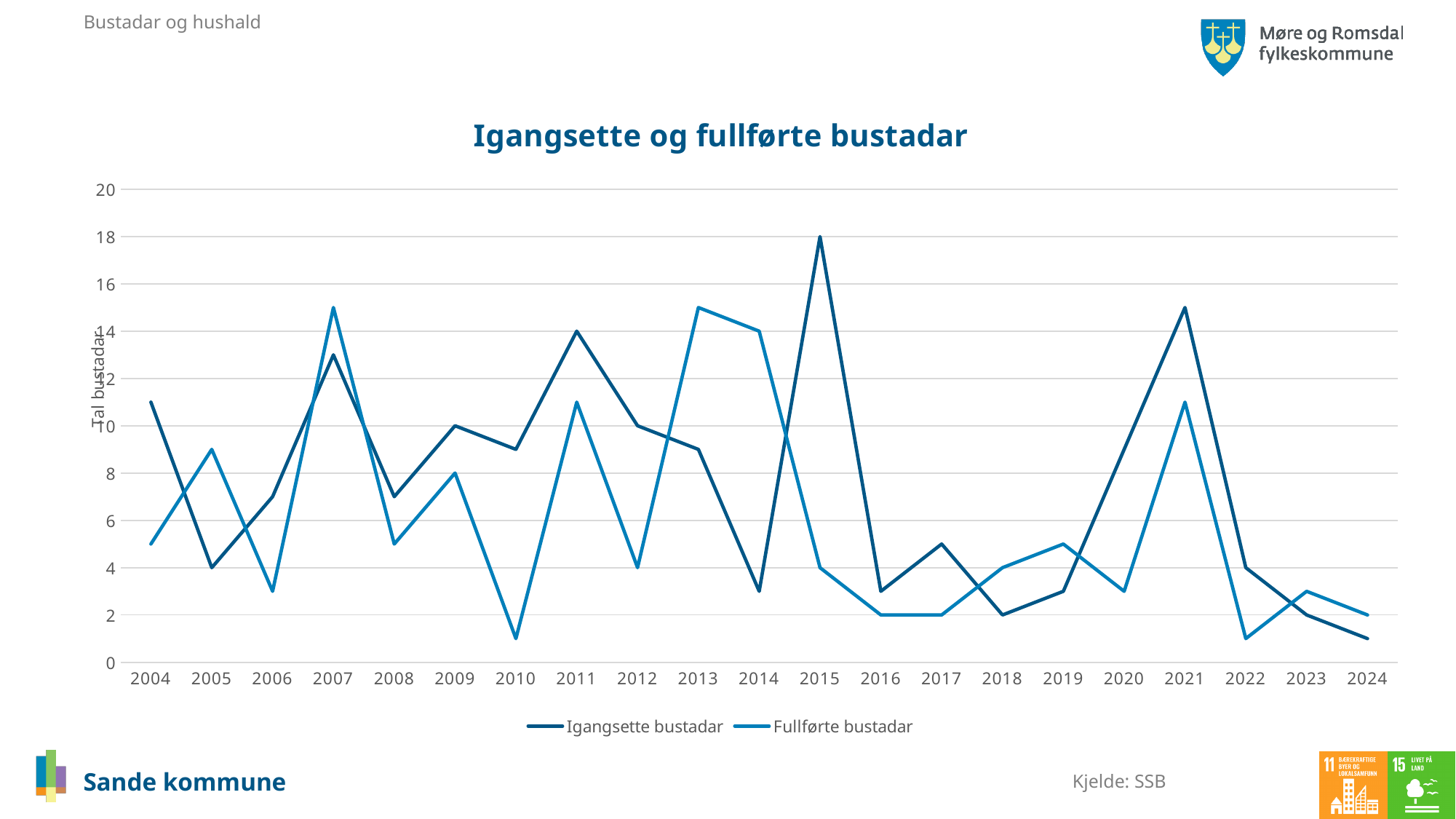
What is the value for Fullførte bustadar in 2014? 14 How many years are shown on the x axis? 21 How many series does the legend list? 2 In which year is Igangsette bustadar highest? 2015 In 2015, which series has the larger value, Igangsette bustadar or Fullførte bustadar? Igangsette bustadar In 2013, which series has the larger value, Igangsette bustadar or Fullførte bustadar? Fullførte bustadar Is the value for Igangsette bustadar in 2021 greater or less than 10? greater Is the value for Igangsette bustadar in 2016 greater or less than 6? less What is the value for Igangsette bustadar in 2015? 18 What is the value for Igangsette bustadar in 2009? 10 What is the title of the chart? Igangsette og fullførte bustadar What kind of chart is shown on the slide? line chart